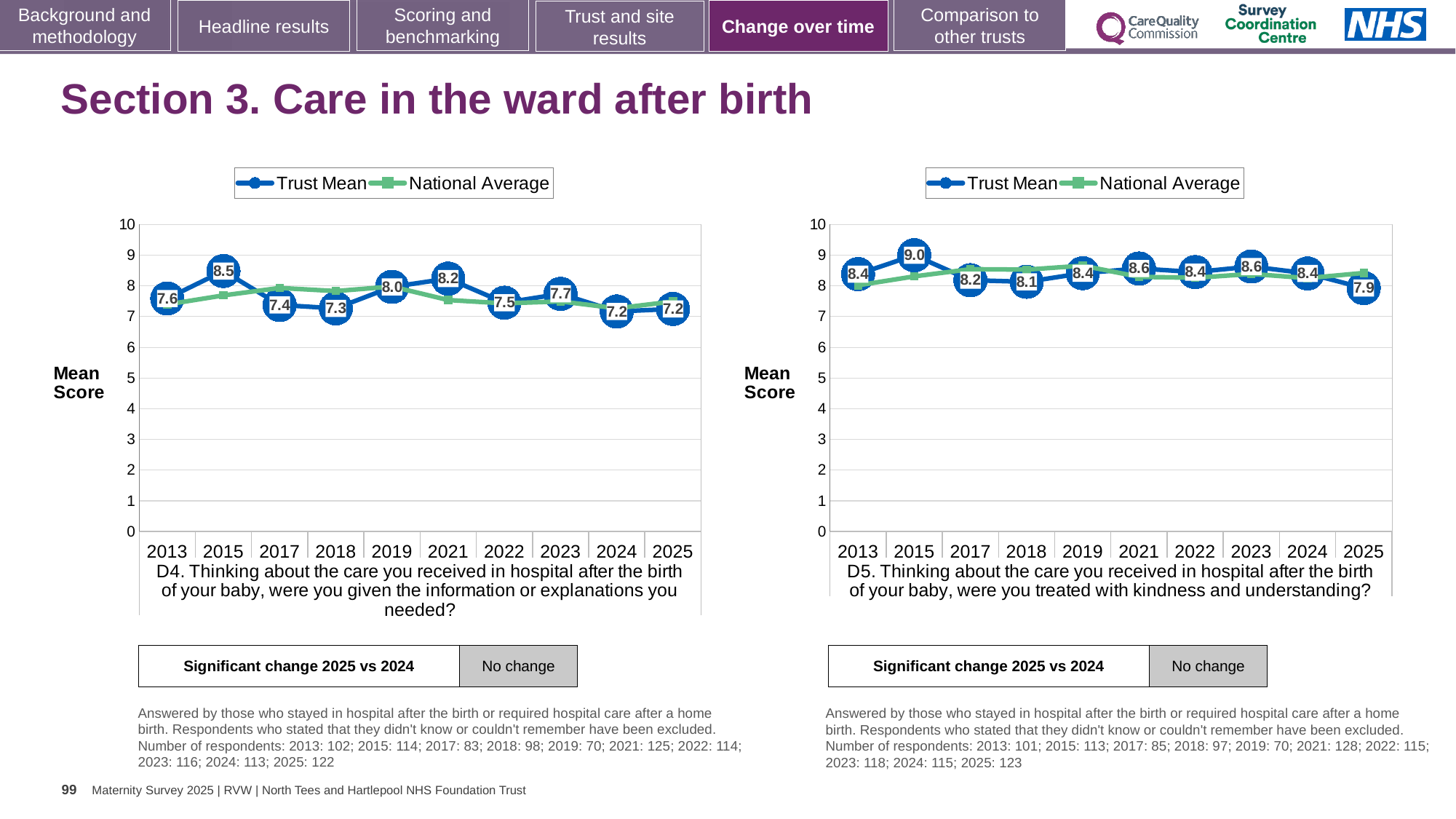
On the D5 chart (right), in which year is the Trust Mean lowest? 2025 On the D4 chart (left), what is the Trust Mean score for 2025? 7.2 On the D5 chart (right), is the National Average value for 2025 greater or less than 8? greater How many series does the legend of the D5 chart (right) list? 2 On the D4 chart (left), what is the Trust Mean score for 2015? 8.5 How many years are plotted on the D4 chart (left)? 10 On the D4 chart (left), is the Trust Mean higher in 2019 or in 2022? 2019 On the D5 chart (right), what is the difference between the Trust Mean in 2015 and in 2025? 1.1 On the D4 chart (left), in which year is the Trust Mean highest? 2015 On the D4 chart (left), what is the difference between the Trust Mean in 2015 and in 2018? 1.2 On the D5 chart (right), what is the Trust Mean score for 2018? 8.1 On the D5 chart (right), in which year is the Trust Mean highest? 2015